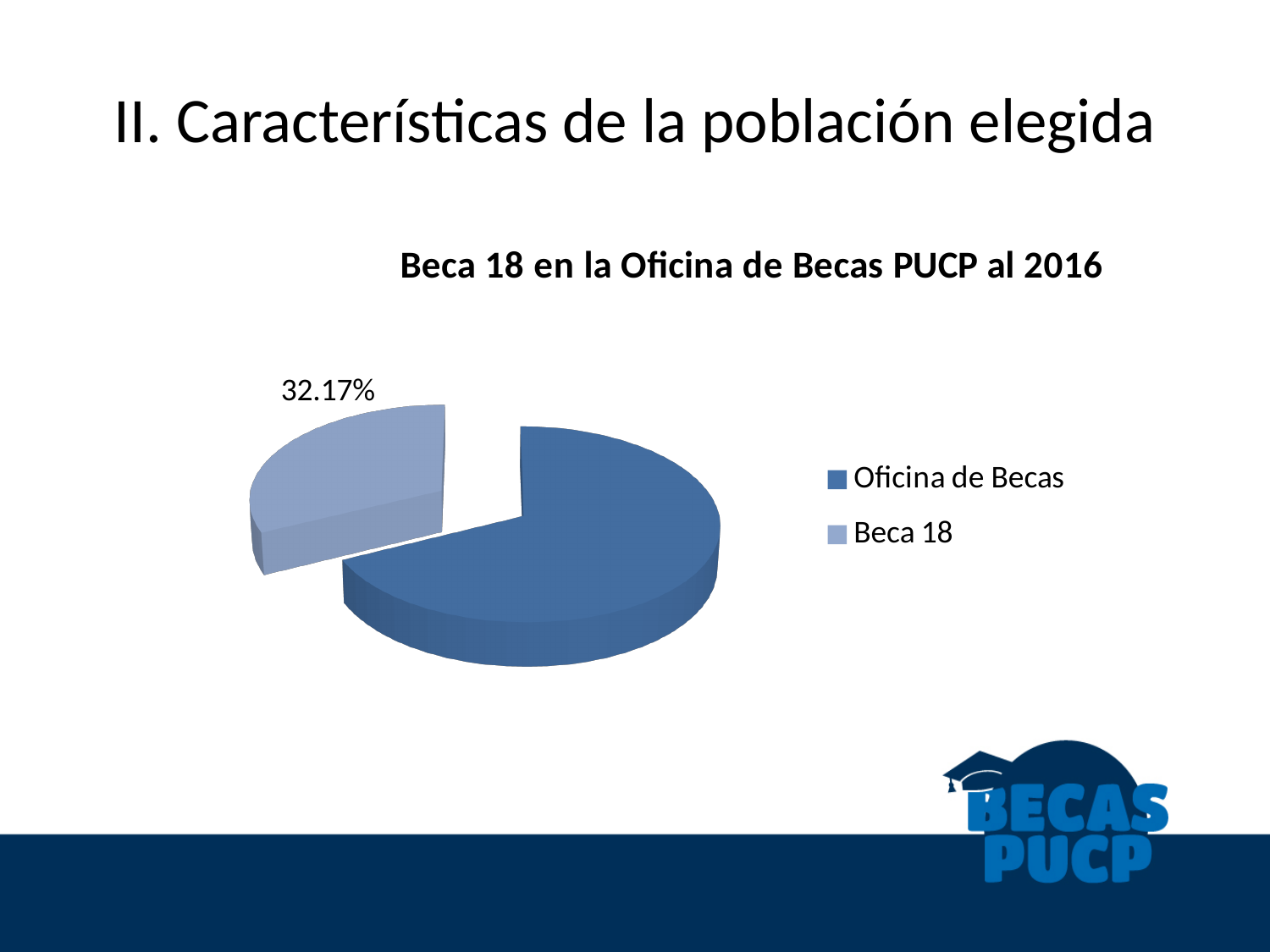
Which is larger, the Oficina de Becas slice or the Beca 18 slice? Oficina de Becas What kind of chart is shown on the slide? Pie chart Which legend entry is shown in the lighter blue colour? Beca 18 Does the Oficina de Becas slice account for more or less than half of the pie? more How many slices does the pie chart have? 2 Which slice of the pie is the smallest? Beca 18 Which slice has its percentage value printed on the chart? Beca 18 What percentage of the pie does Beca 18 represent? 32.17% What is the title of the chart? Beca 18 en la Oficina de Becas PUCP al 2016 Which slice of the pie is the largest? Oficina de Becas How many entries does the legend list? 2